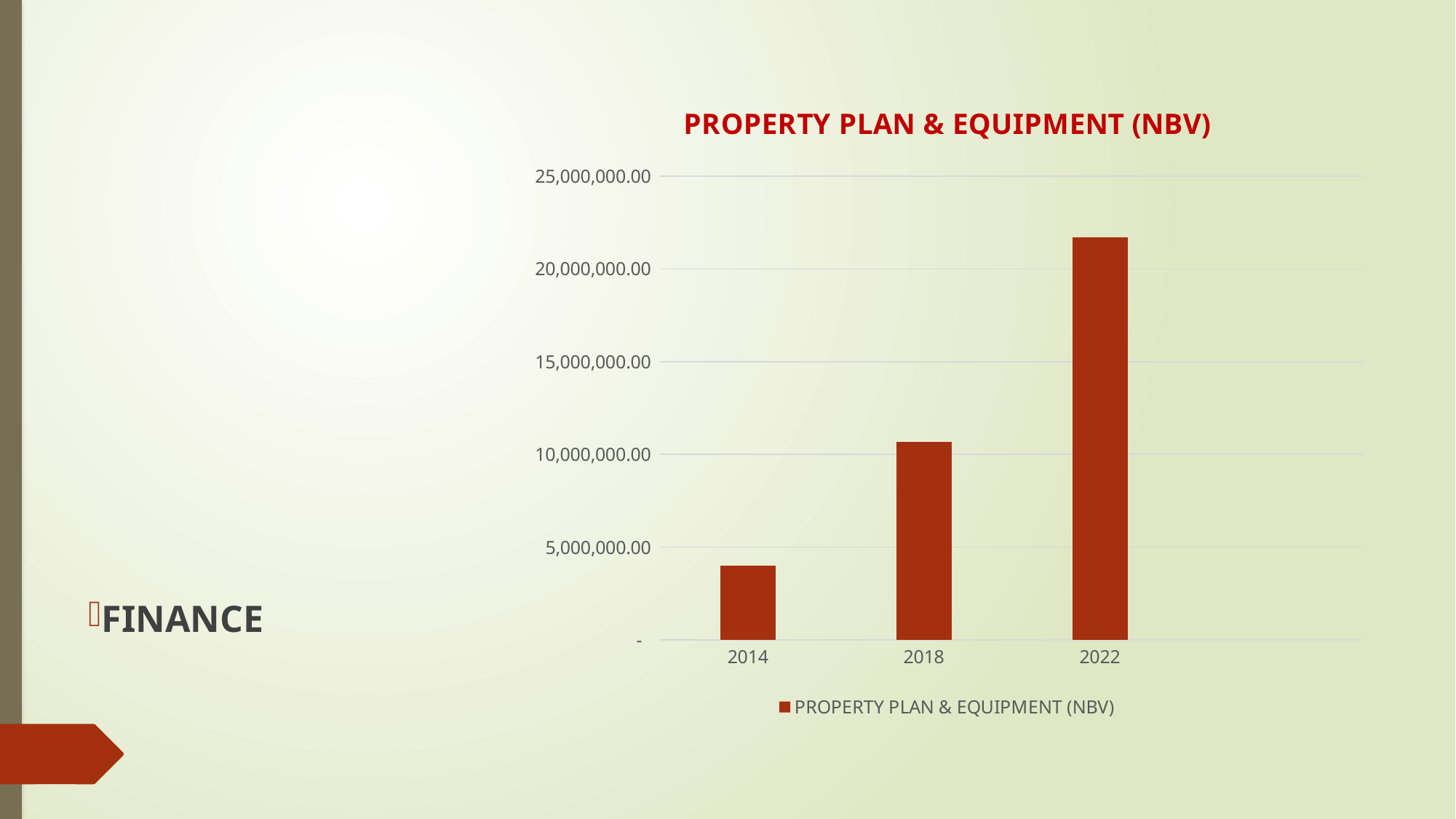
What kind of chart is shown on the slide? bar chart What is the highest value labelled on the vertical axis of the chart? 25,000,000.00 What is the title of the chart? PROPERTY PLAN & EQUIPMENT (NBV) Which year has the highest Property Plan & Equipment (NBV) value? 2022 Is the value for 2018 greater or less than 10,000,000.00? greater Which year has the larger value, 2014 or 2018? 2018 Is the value for 2014 greater or less than 5,000,000.00? less Which year has the lowest Property Plan & Equipment (NBV) value? 2014 How many years are shown on the x axis of the chart? 3 Do the values rise or fall from 2014 to 2022? rise Is the value for 2022 greater or less than 20,000,000.00? greater How many series does the chart legend list? 1